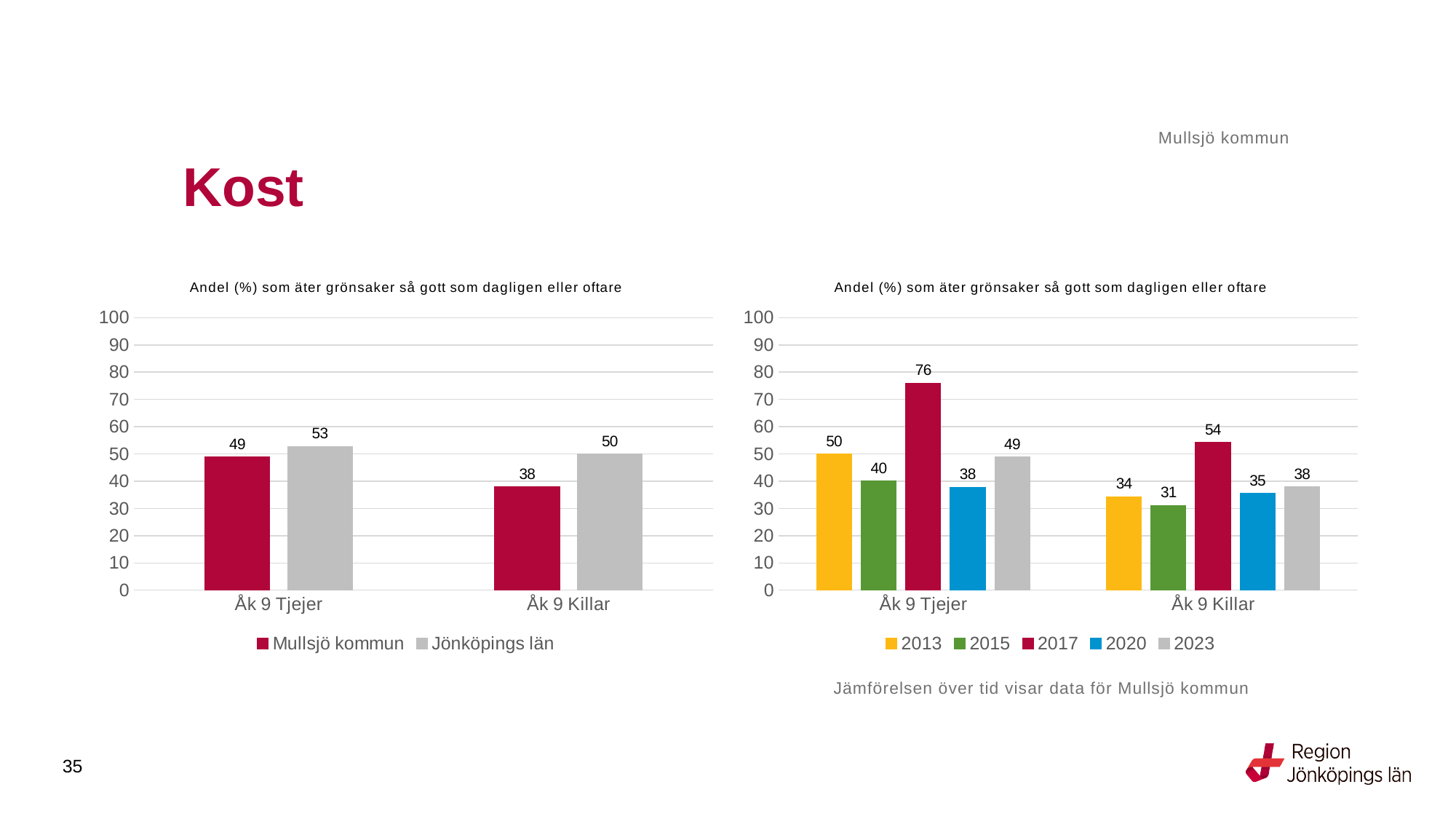
In the right chart, which year has the highest value for Åk 9 Tjejer? 2017 In the left chart, what is the value for Jönköpings län for Åk 9 Killar? 50 In the right chart, which year has the lowest value for Åk 9 Killar? 2015 In the left chart, which is larger for Åk 9 Tjejer: Mullsjö kommun or Jönköpings län? Jönköpings län In the left chart, what is the value for Mullsjö kommun for Åk 9 Tjejer? 49 In the right chart, what is the value for 2015 for Åk 9 Killar? 31 In the left chart, what is the difference between Jönköpings län and Mullsjö kommun for Åk 9 Killar? 12 How many series does the legend of the right chart list? 5 How many series does the legend of the left chart list? 2 What kind of chart is the right chart? Bar chart In the right chart, what is the value for 2017 for Åk 9 Tjejer? 76 In the right chart, what is the difference between the 2017 and 2023 values for Åk 9 Tjejer? 27